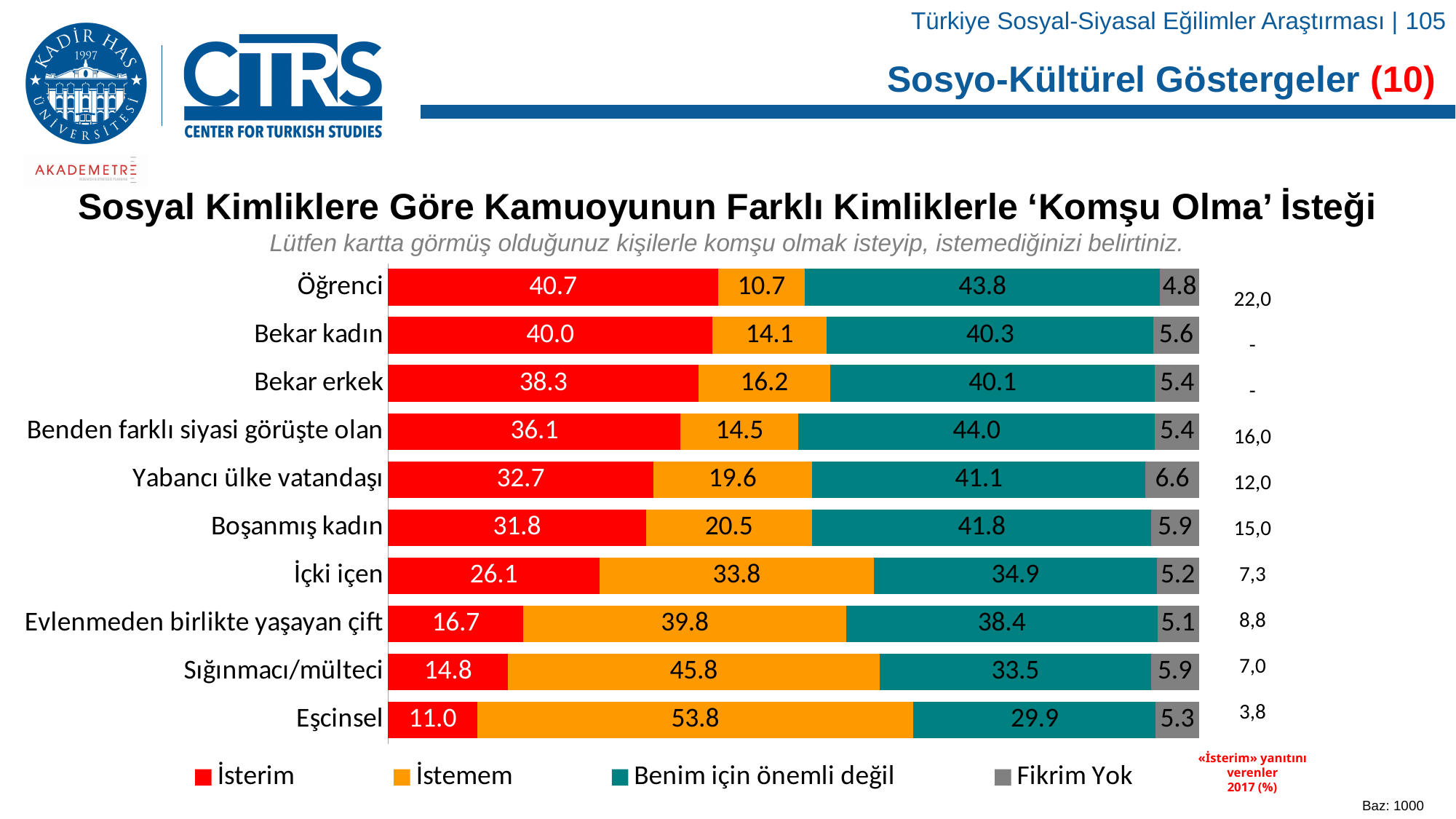
How many categories (social identities) are shown in the chart? 10 Which category has the highest 'İstemem' value? Eşcinsel What is the 'İsterim' value for Öğrenci? 40.7 What type of chart is shown on the slide? Stacked bar chart Which category has the lowest 'İsterim' value? Eşcinsel What is the 'İstemem' value for Sığınmacı/mülteci? 45.8 What is the difference between the 'İstemem' values for Eşcinsel and Öğrenci? 43.1 How many series does the legend list? 4 Which category has the highest 'Fikrim Yok' value? Yabancı ülke vatandaşı Which is larger: the 'İsterim' value for İçki içen or for Evlenmeden birlikte yaşayan çift? İçki içen What is the total of the stacked bar for Eşcinsel? 100.0 What is the 'Benim için önemli değil' value for Boşanmış kadın? 41.8